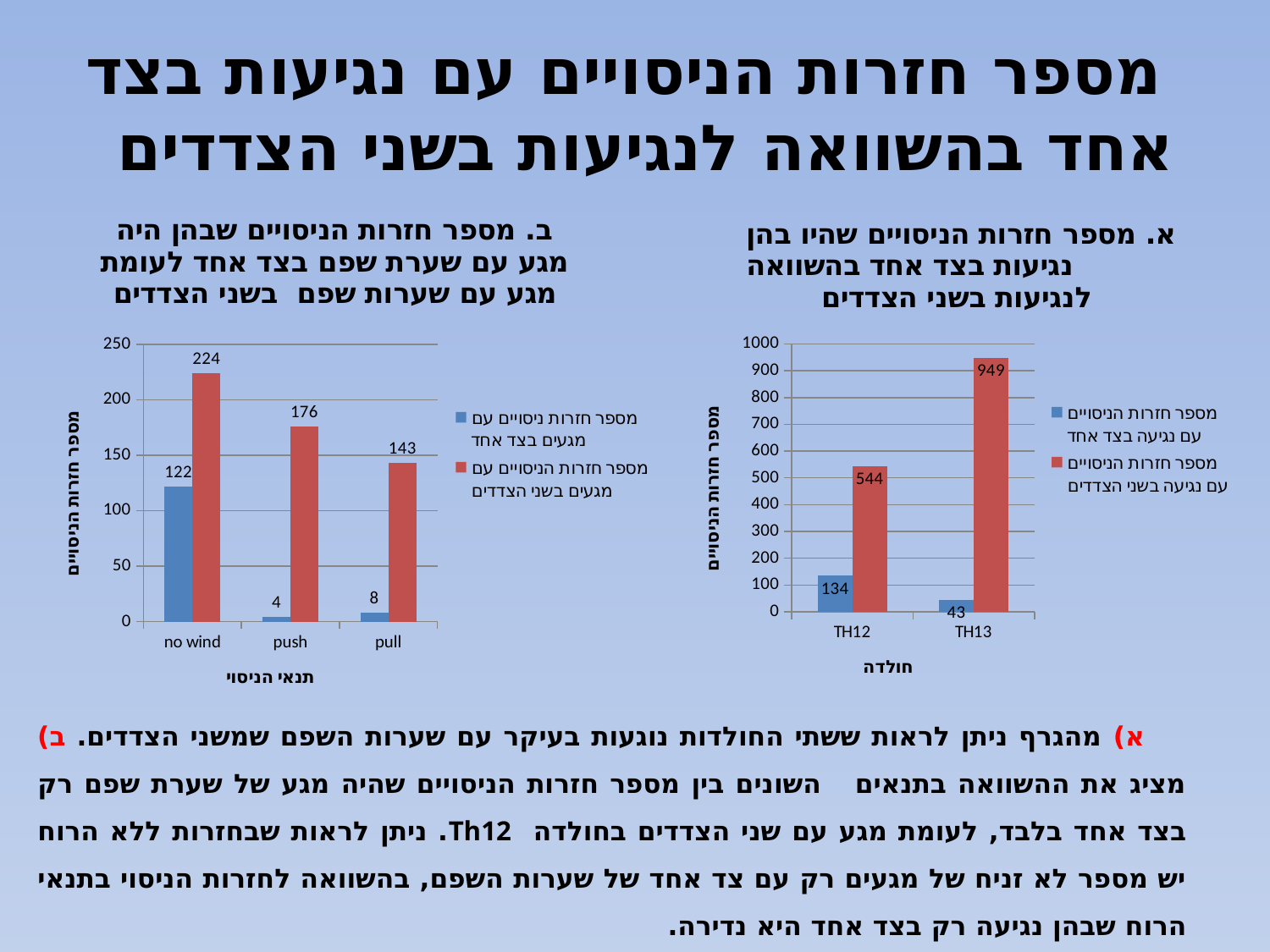
In the chart on the left, what is the value of the red series for 'push'? 176 In the chart on the left, which category has the highest red (two-sided touch) value? no wind In the chart on the left, which category has the lowest blue (one-sided touch) value? push In the chart on the right, which category has the lowest blue (one-sided touch) value? TH13 In the chart on the right, what is the value of the blue series (one-sided touch) for TH12? 134 In the chart on the right, what is the value of the red series (two-sided touch) for TH13? 949 What type of chart is the chart on the left? bar chart In the chart on the right, how many series does the legend list? 2 In the chart on the left, what is the value of the blue series for 'no wind'? 122 In the chart on the left, how many categories are shown on the x axis? 3 In the chart on the right, what is the difference between the red bar and the blue bar for TH12? 410 In the chart on the left, what is the difference between the red and blue bars for 'pull'? 135